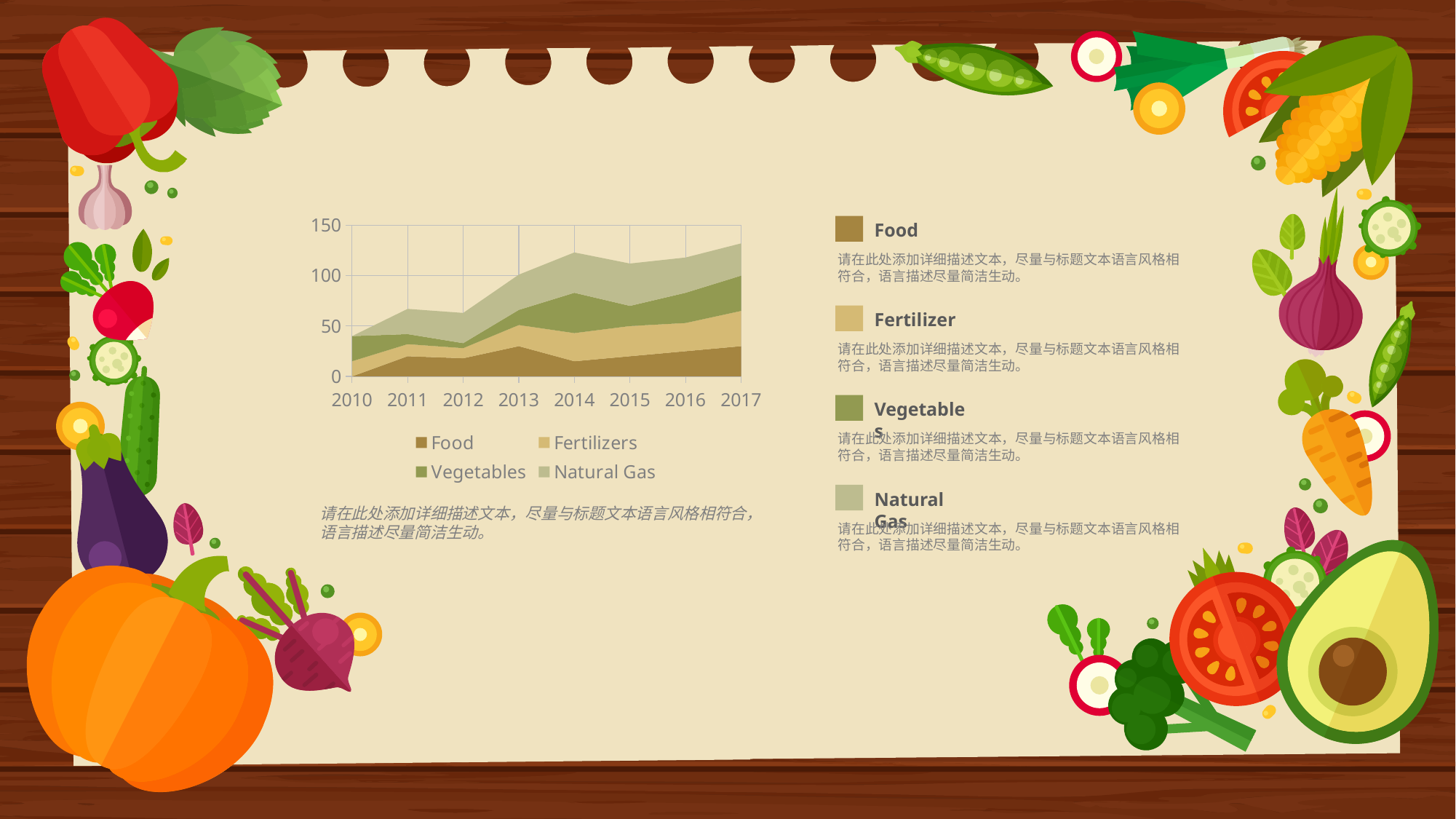
Which series are listed in the chart's legend? Food, Fertilizers, Vegetables, Natural Gas How many years are shown along the x axis of the chart? 8 Is the stacked total for 2010 greater or less than 50? less Is the stacked total for 2014 greater or less than 100? greater Which year has the lowest stacked total on the chart? 2010 What kind of chart is shown on the slide? Area chart Is the stacked total for 2012 greater or less than 100? less Is the stacked total for 2017 larger or smaller than the stacked total for 2010? larger How many series does the chart's legend list? 4 Does the stacked total generally rise or fall from 2010 to 2017? rise What is the first year shown on the chart's x axis? 2010